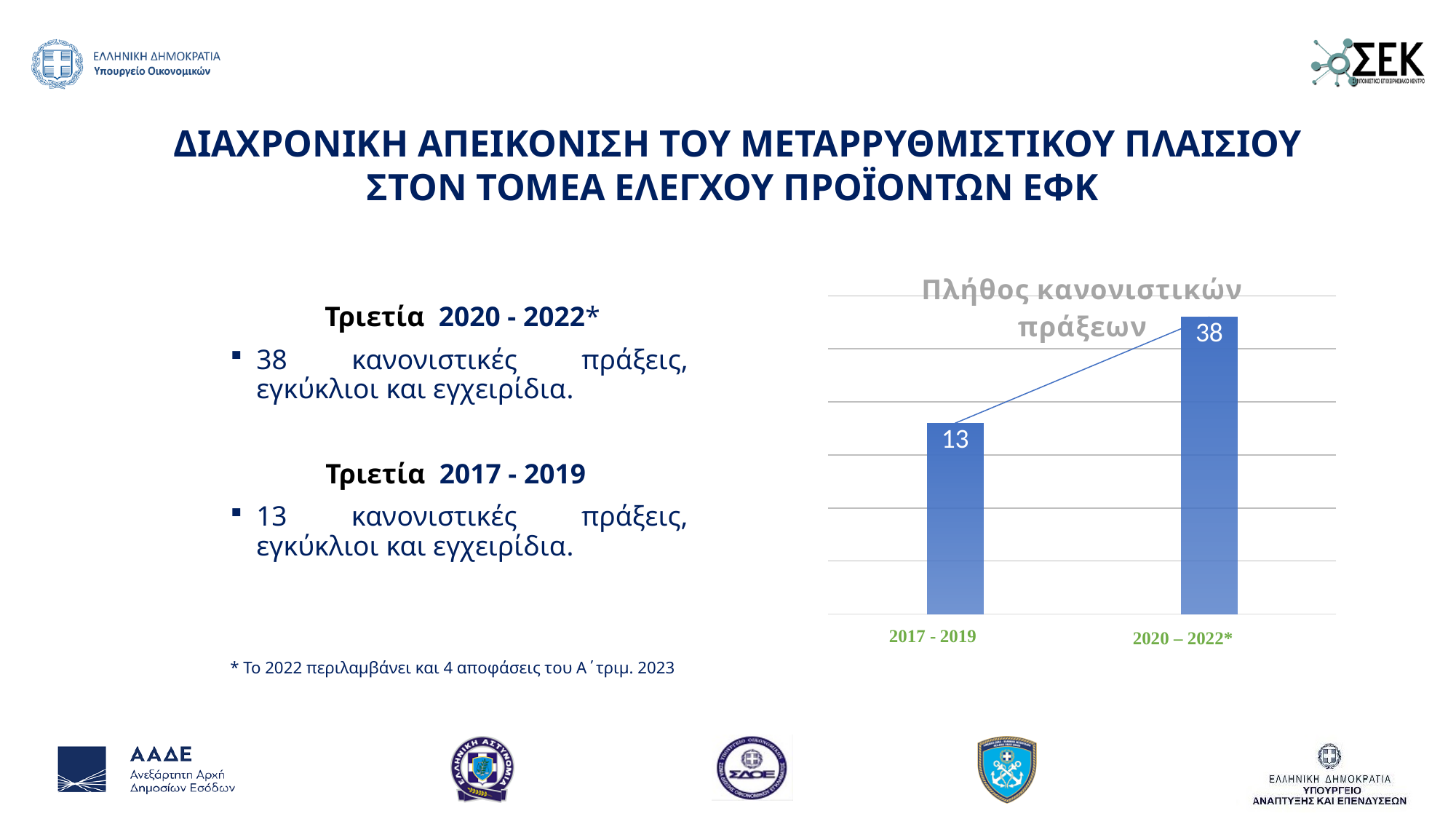
What is the value for 2020 – 2022* in the chart? 38 How many categories are shown in the chart? 2 What is the value for 2017 - 2019 in the chart? 13 What is the title of the chart? Πλήθος κανονιστικών πράξεων What colour are the bars in the chart? blue Which period has the highest value in the chart? 2020 – 2022* What kind of chart is shown on the slide? bar chart What is the difference between the values for 2020 – 2022* and 2017 - 2019? 25 Which is larger, the value for 2017 - 2019 or the value for 2020 – 2022*? 2020 – 2022* Do the values rise or fall from 2017 - 2019 to 2020 – 2022*? rise Which period has the lowest value in the chart? 2017 - 2019